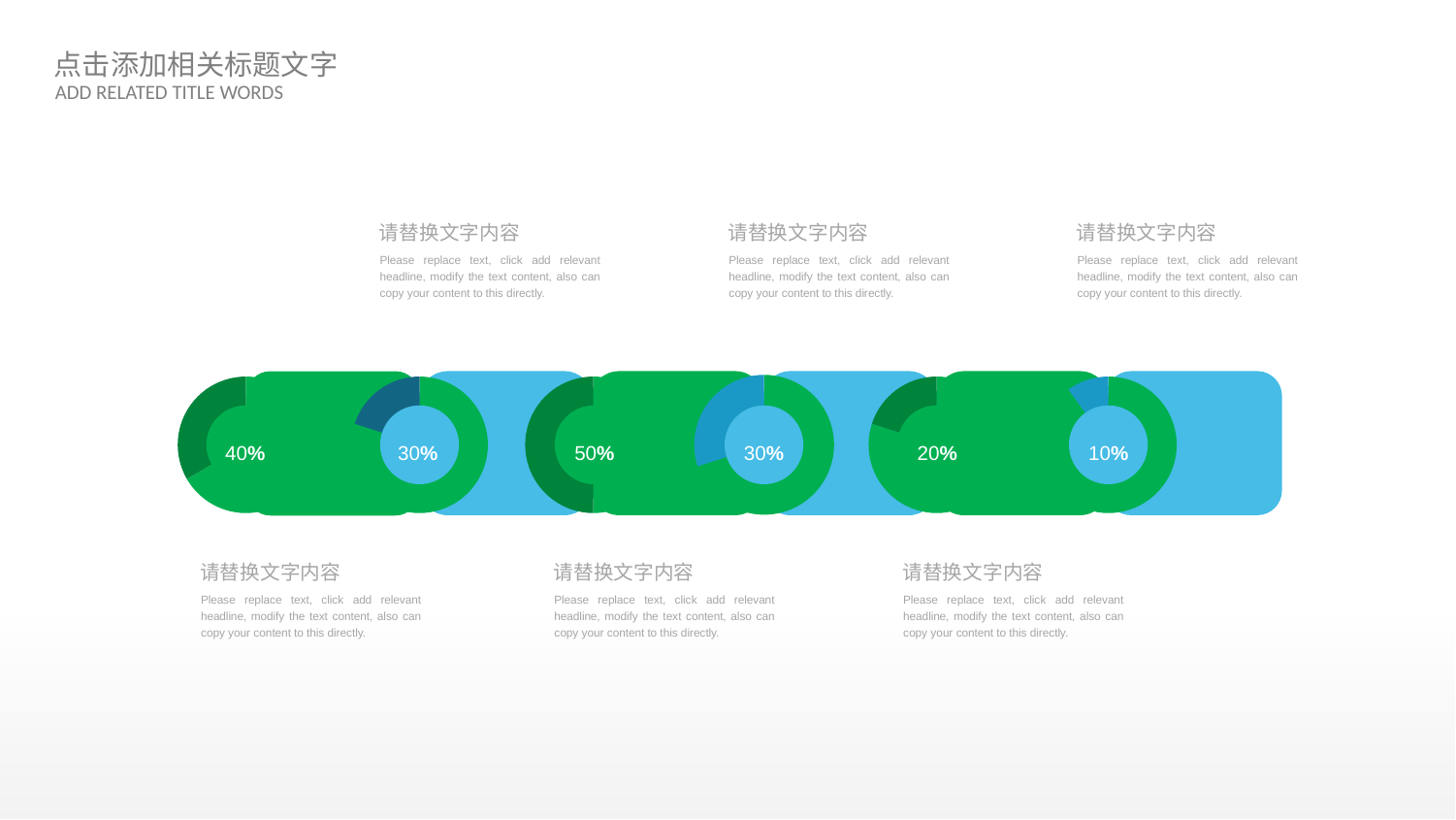
How many donut charts are shown on the slide? 6 Which is larger, the value in the first donut chart or the value in the fifth donut chart? The first donut chart (40%) What value is shown in the last (rightmost) donut chart? 10% What is the difference between the values in the first donut chart (40%) and the second donut chart (30%)? 10% What is the difference between the value in the third donut chart (50%) and the value in the rightmost donut chart (10%)? 40% Which donut chart shows the highest value? The third from the left (50%) What value is shown in the fifth donut chart from the left? 20% What value is shown in the first (leftmost) donut chart? 40% What value is shown in the third donut chart from the left? 50% What value is shown in the second donut chart from the left? 30% Which donut chart shows the lowest value? The rightmost (10%) What kind of chart is used to display the percentages on the slide? Donut chart